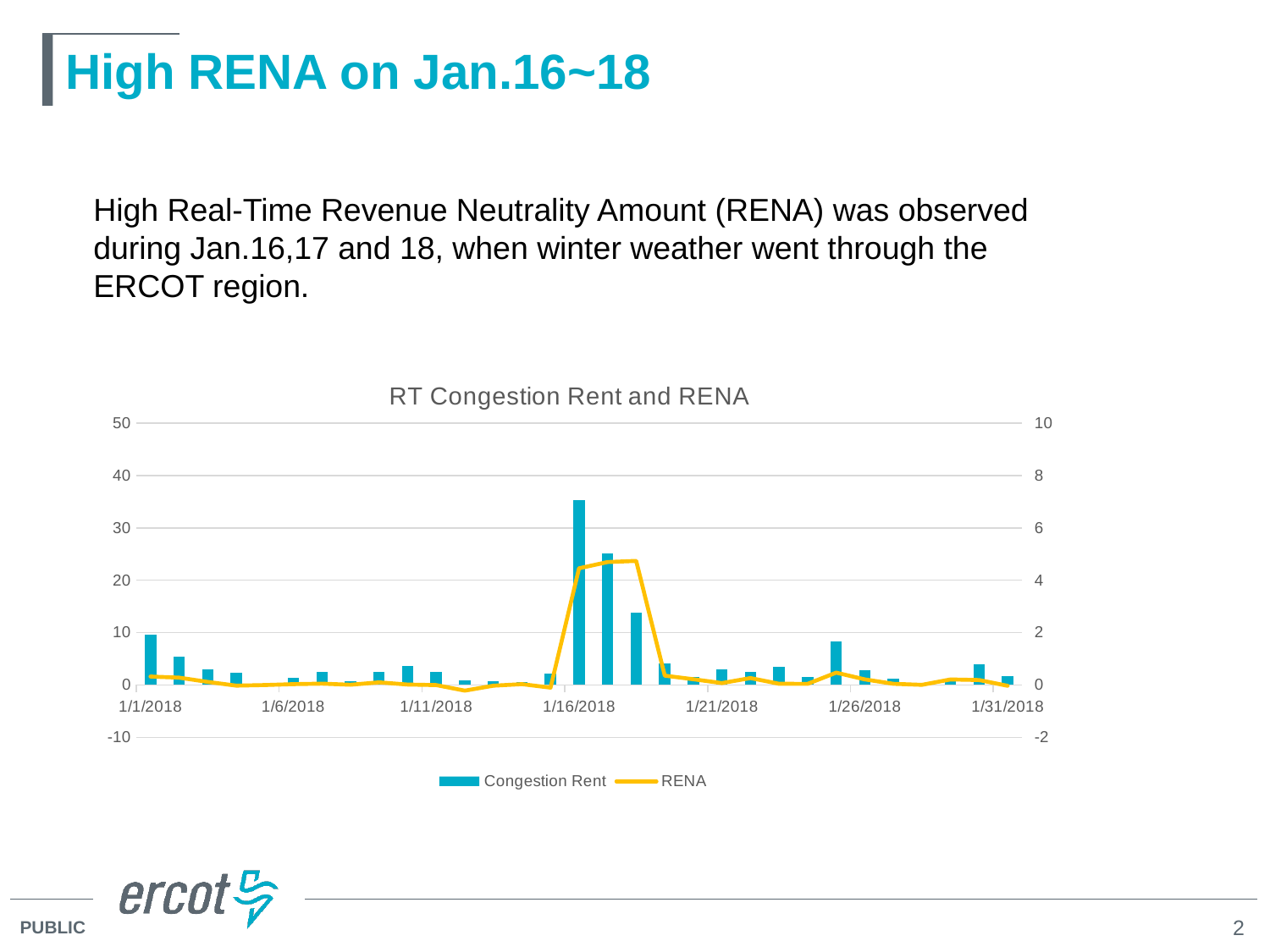
Is the Congestion Rent value on 1/21/2018 greater or less than 10? less Which has the larger Congestion Rent value, 1/16/2018 or 1/26/2018? 1/16/2018 Is the RENA value on 1/16/2018 greater or less than 2 on the right axis? greater What kind of chart is shown? Combined bar and line chart What are the two series named in the legend? Congestion Rent and RENA Is the Congestion Rent value on 1/16/2018 greater or less than 30? greater What is the title of the chart? RT Congestion Rent and RENA How many series does the chart's legend list? 2 On which date is the Congestion Rent bar highest? 1/16/2018 Does the RENA line rise or fall between 1/16/2018 and 1/21/2018? fall